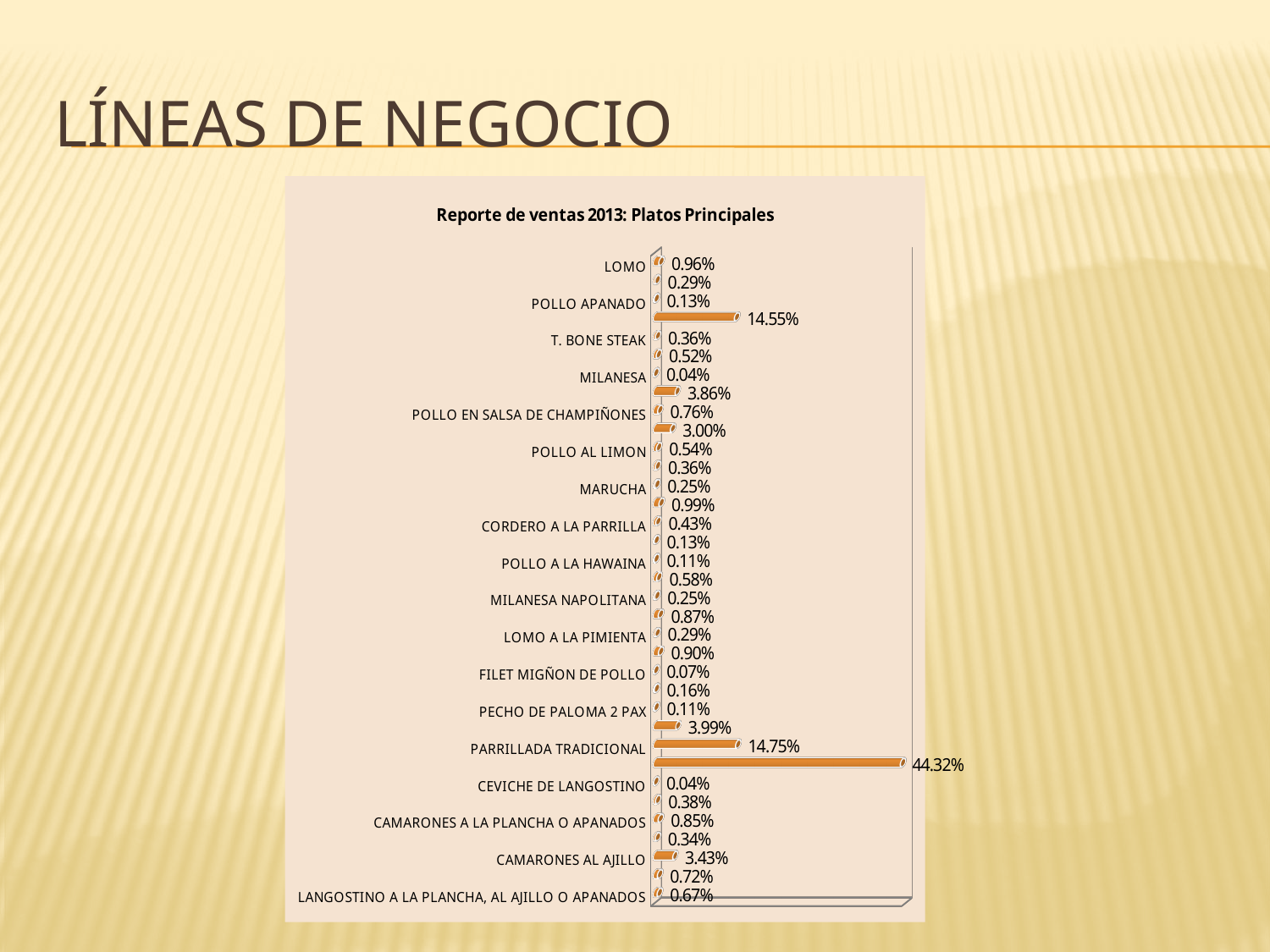
What type of chart is shown on the slide? bar chart What is the value for LOMO? 0.96% What is the value for CAMARONES AL AJILLO? 3.43% What is the difference between the values for LOMO and POLLO APANADO? 0.83% What is the difference between the values for PARRILLADA TRADICIONAL and CAMARONES AL AJILLO? 11.32% What is the value for CEVICHE DE LANGOSTINO? 0.04% What is the value for POLLO EN SALSA DE CHAMPIÑONES? 0.76% What is the title of the chart? Reporte de ventas 2013: Platos Principales What is the value for LANGOSTINO A LA PLANCHA, AL AJILLO O APANADOS? 0.67% What is the value for PARRILLADA TRADICIONAL? 14.75% What is the largest value shown in the chart? 44.32% Which is larger, the value for PARRILLADA TRADICIONAL or the value for CAMARONES AL AJILLO? PARRILLADA TRADICIONAL